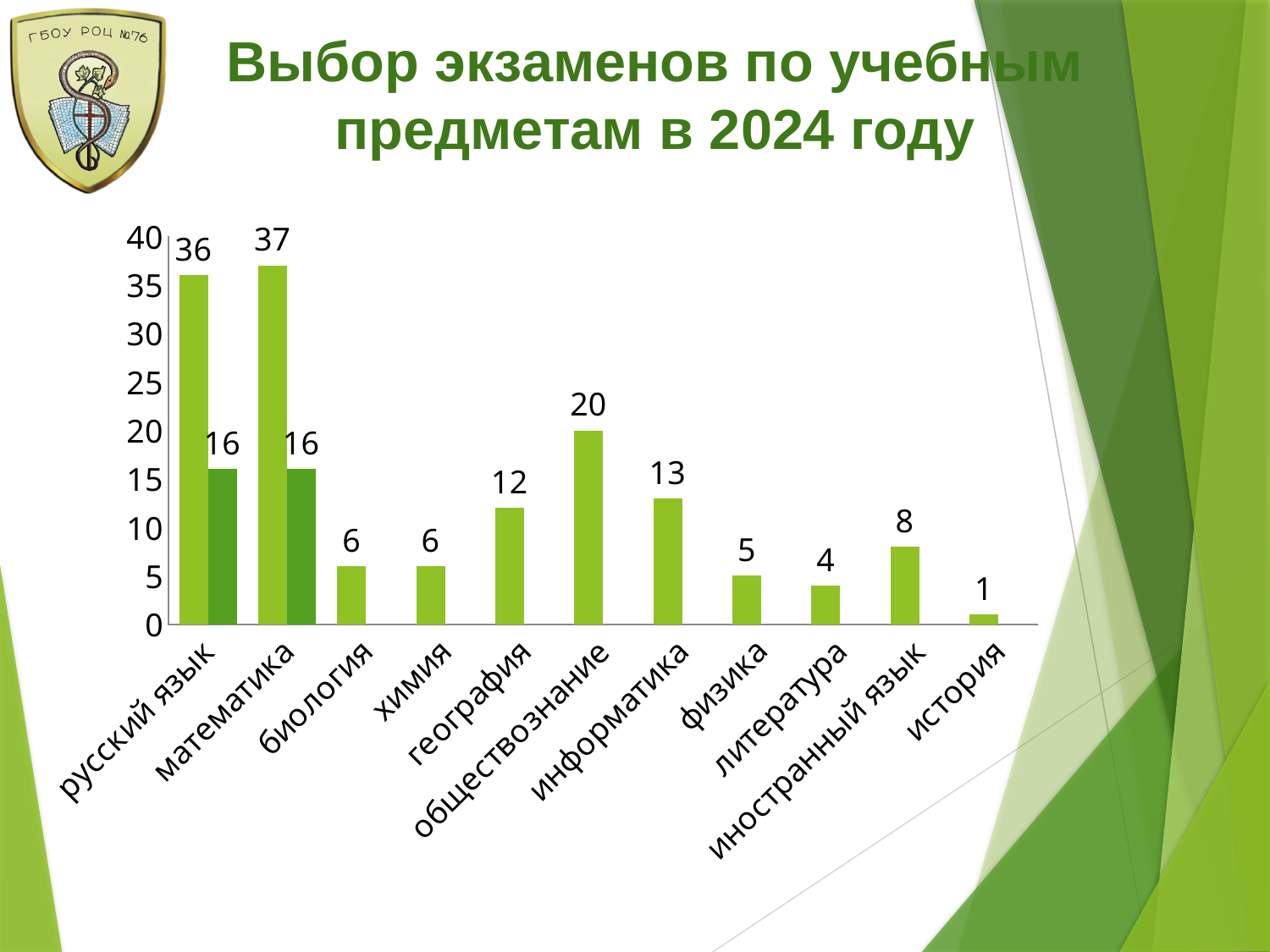
What is the value of the dark green bar for русский язык? 16 What is the value of the light green bar for информатика? 13 What is the difference between the values for обществознание and география? 8 Which category has the highest light green bar? математика What is the title of the slide? Выбор экзаменов по учебным предметам в 2024 году What is the difference between the light green bars for математика and русский язык? 1 What is the value of the light green bar for история? 1 Which category has the lowest value on the chart? история What is the value of the light green bar for обществознание? 20 Which is larger, the value for физика or the value for литература? физика What type of chart is shown on the slide? bar chart How many categories are shown on the x axis? 11